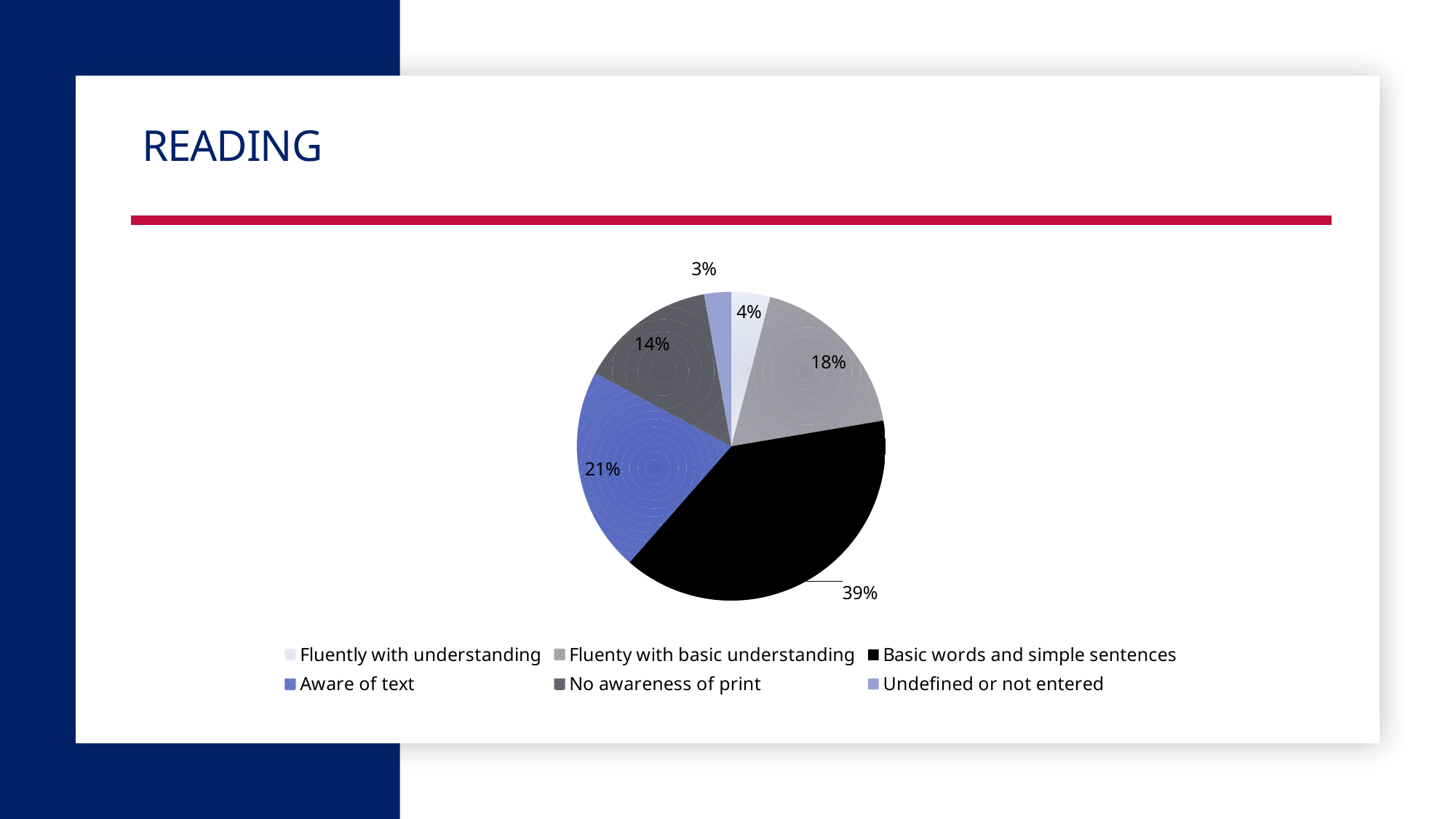
Which category has the largest slice of the pie? Basic words and simple sentences Which category has the smallest slice of the pie? Undefined or not entered What share of the pie is labelled "Fluently with understanding"? 4% What share of the pie is labelled "Aware of text"? 21% Which is larger, the slice for "Fluenty with basic understanding" or the slice for "No awareness of print"? Fluenty with basic understanding What kind of chart is shown on the slide? Pie chart What share of the pie is labelled "Fluenty with basic understanding"? 18% What is the difference in percentage points between "Basic words and simple sentences" and "Aware of text"? 18 How many categories does the legend list? 6